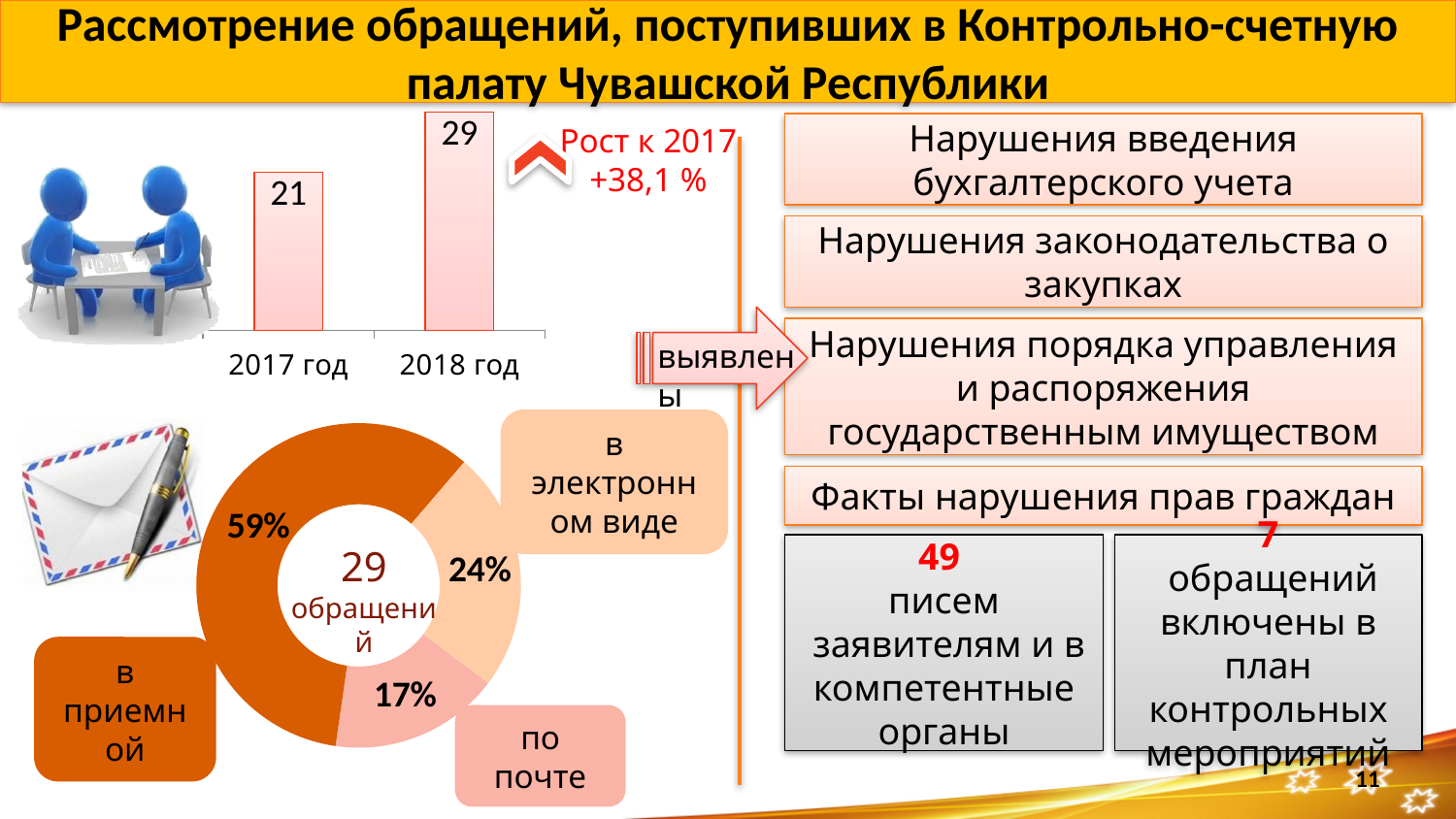
In the bar chart, do the values rise or fall from 2017 год to 2018 год? rise In the donut chart, what share of обращений came по почте? 17% What type of chart shows the values for 2017 год and 2018 год? bar chart In the donut chart, what share of обращений came в приемной? 59% In the donut chart, how many categories are shown? 3 In the bar chart, what is the value for 2018 год? 29 In the bar chart, what is the difference between the 2018 год and 2017 год values? 8 In the bar chart, which year has the higher value? 2018 год In the donut chart, which category has the smallest share? по почте In the bar chart, how many bars are shown? 2 In the donut chart, what share of обращений came в электронном виде? 24% In the bar chart, what is the value for 2017 год? 21